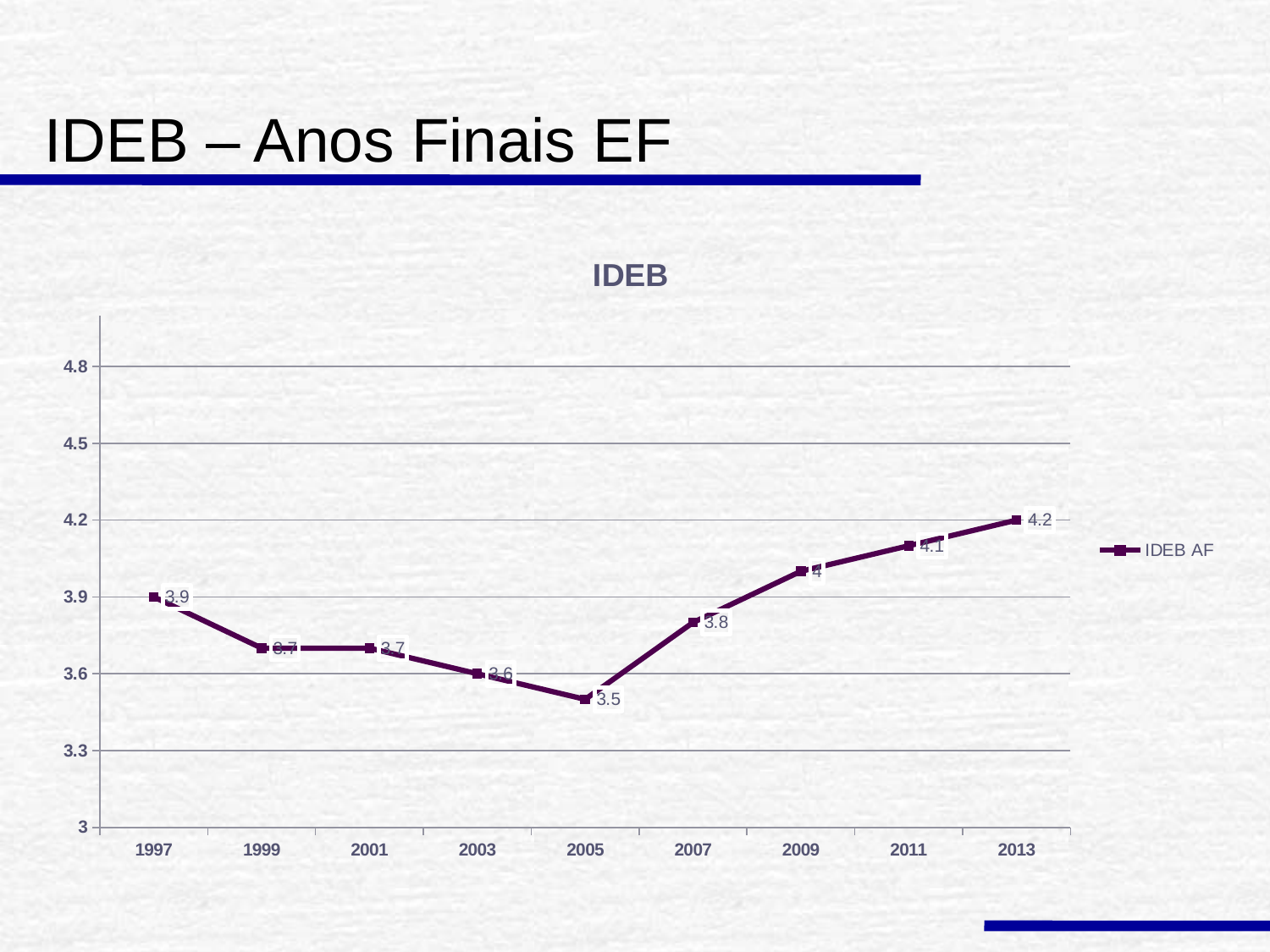
Which year has the lowest IDEB AF value? 2005 Which is larger, the IDEB AF value for 1997 or for 2007? 1997 How many years are plotted on the x axis? 9 Do the IDEB AF values rise or fall from 2005 to 2013? Rise What is the IDEB AF value for 2005? 3.5 How many series does the legend list? 1 What kind of chart is shown on the slide? Line chart What is the IDEB AF value for 1997? 3.9 What is the difference between the IDEB AF values for 2013 and 2005? 0.7 Which year has the highest IDEB AF value? 2013 What is the IDEB AF value for 2009? 4 What is the IDEB AF value for 2013? 4.2